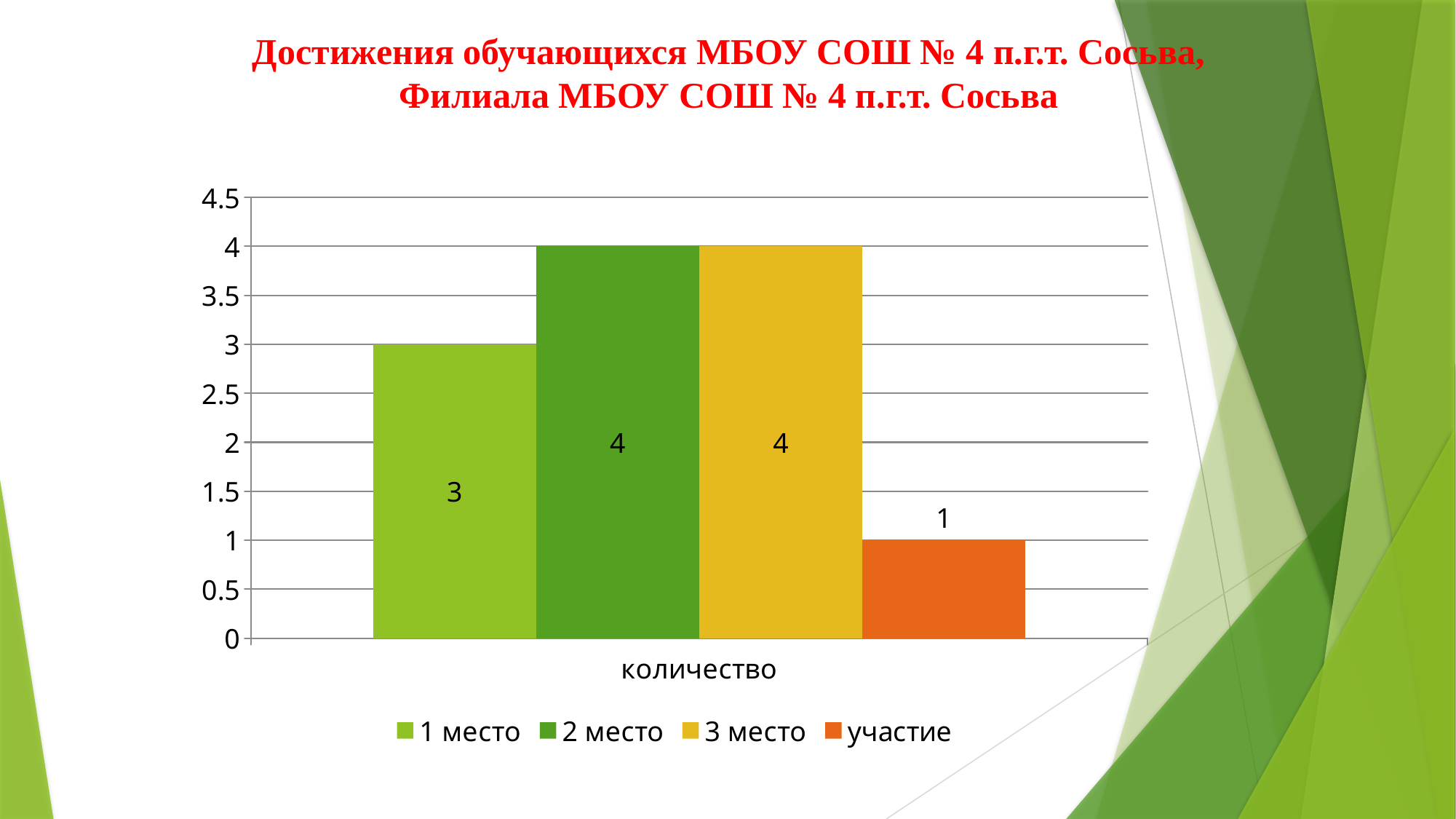
What is the difference between the values for "3 место" and "1 место"? 1 What is the label on the x axis under the bars? количество What is the value for "1 место"? 3 What is the value for "2 место"? 4 Is the value for "1 место" greater or less than 2? greater Which is larger, the value for "1 место" or the value for "участие"? 1 место What is the difference between the values for "2 место" and "участие"? 3 Which series has the lowest value? участие What kind of chart is shown on the slide? bar chart What is the value for "участие"? 1 What is the value for "3 место"? 4 How many series does the legend list? 4